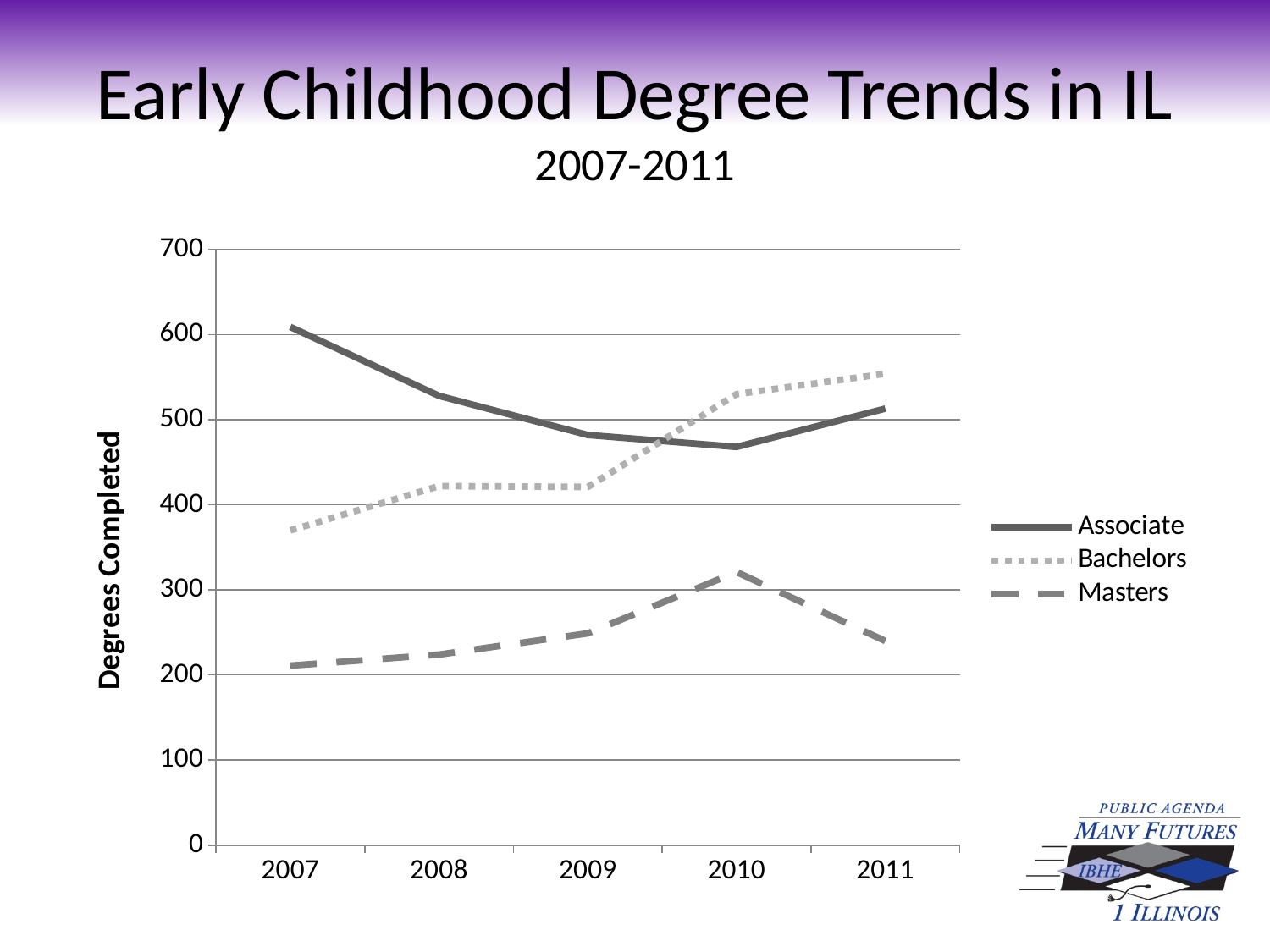
In 2007, which is larger: Associate or Bachelors? Associate Is the value for Masters in 2007 greater or less than 300? less Is the value for Associate in 2007 greater or less than 500? greater Is the value for Bachelors in 2011 greater or less than 500? greater How many series does the legend list? 3 What is the title of the y axis? Degrees Completed What kind of chart is shown on the slide? line chart How many years are plotted along the x axis? 5 In 2011, which is larger: Associate or Bachelors? Bachelors In which year is the Masters line at its highest? 2010 Does the Masters line rise or fall from 2010 to 2011? fall Does the Bachelors line rise or fall from 2007 to 2011? rise